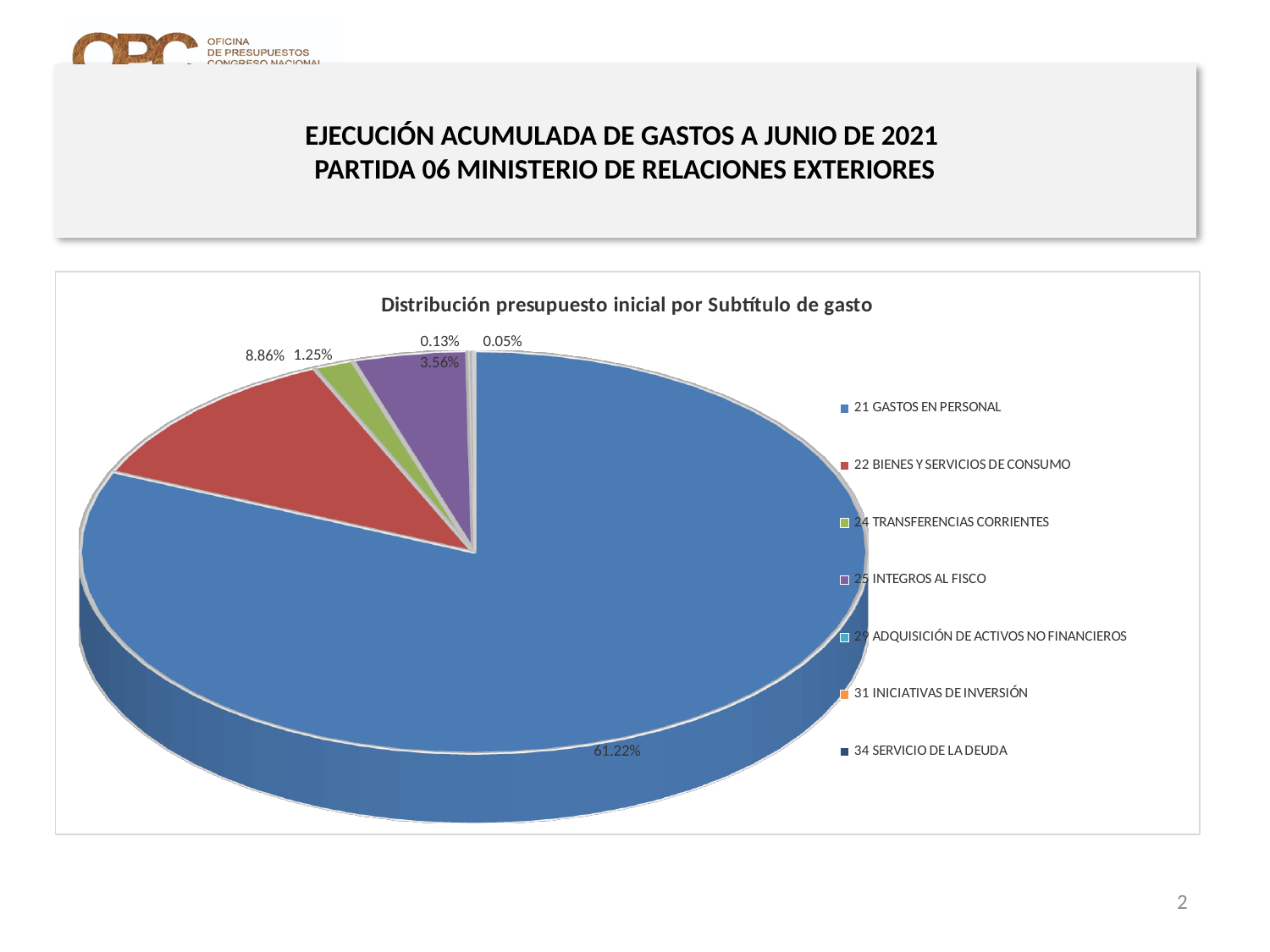
What percentage is shown for 22 BIENES Y SERVICIOS DE CONSUMO? 8.86% How many categories does the legend of the pie chart list? 7 What is the difference in percentage points between 22 BIENES Y SERVICIOS DE CONSUMO and 25 INTEGROS AL FISCO? 5.30% What percentage label is printed on the slice for 21 GASTOS EN PERSONAL? 61.22% What is the title of the pie chart? Distribución presupuesto inicial por Subtítulo de gasto What colour is the slice for 22 BIENES Y SERVICIOS DE CONSUMO? Red Which slice is larger, 24 TRANSFERENCIAS CORRIENTES or 25 INTEGROS AL FISCO? 25 INTEGROS AL FISCO What percentage is shown for 24 TRANSFERENCIAS CORRIENTES? 1.25% What percentage is shown for 25 INTEGROS AL FISCO? 3.56% What kind of chart is shown on the slide? Pie chart Which category has the largest slice of the pie? 21 GASTOS EN PERSONAL Which slice is larger, 22 BIENES Y SERVICIOS DE CONSUMO or 25 INTEGROS AL FISCO? 22 BIENES Y SERVICIOS DE CONSUMO